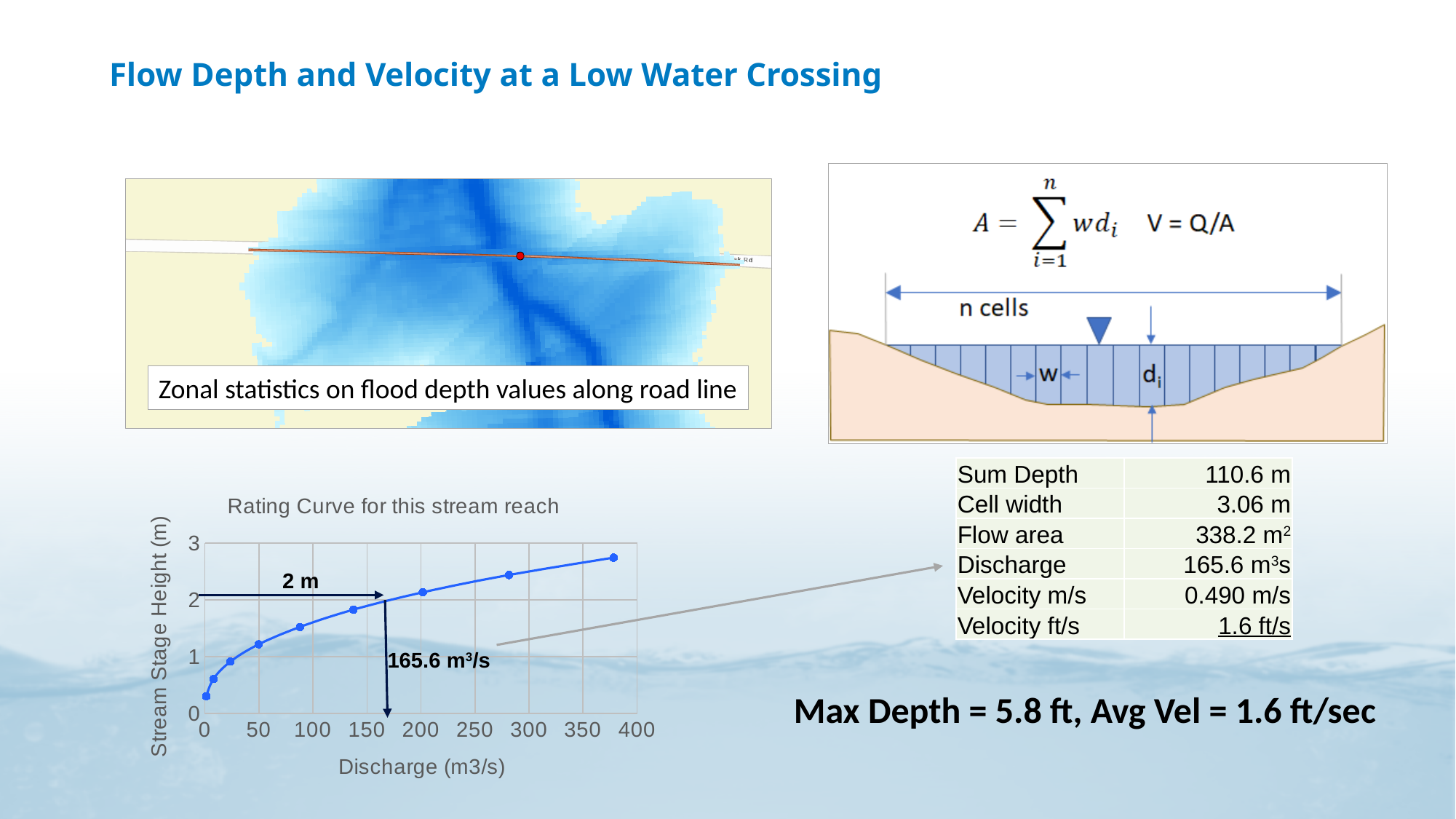
What is the label of the x axis of the chart? Discharge (m3/s) Does the stream stage height rise or fall as discharge increases along the x axis? rises Which has the higher stream stage height: the point at about 50 m3/s or the point at about 280 m3/s? the point at about 280 m3/s What is the title of the chart? Rating Curve for this stream reach What is the highest value shown on the x axis of the chart? 400 Is the stream stage height at the highest plotted discharge greater or less than 3? less Is the stream stage height at the highest plotted discharge (around 380 m3/s) greater or less than 2? greater Is the stream stage height at a discharge of about 50 m3/s greater or less than 1? greater How many data points are plotted on the rating curve? 9 What kind of chart is shown on the slide? line chart According to the annotation on the chart, what discharge corresponds to a stream stage height of 2 m? 165.6 m³/s